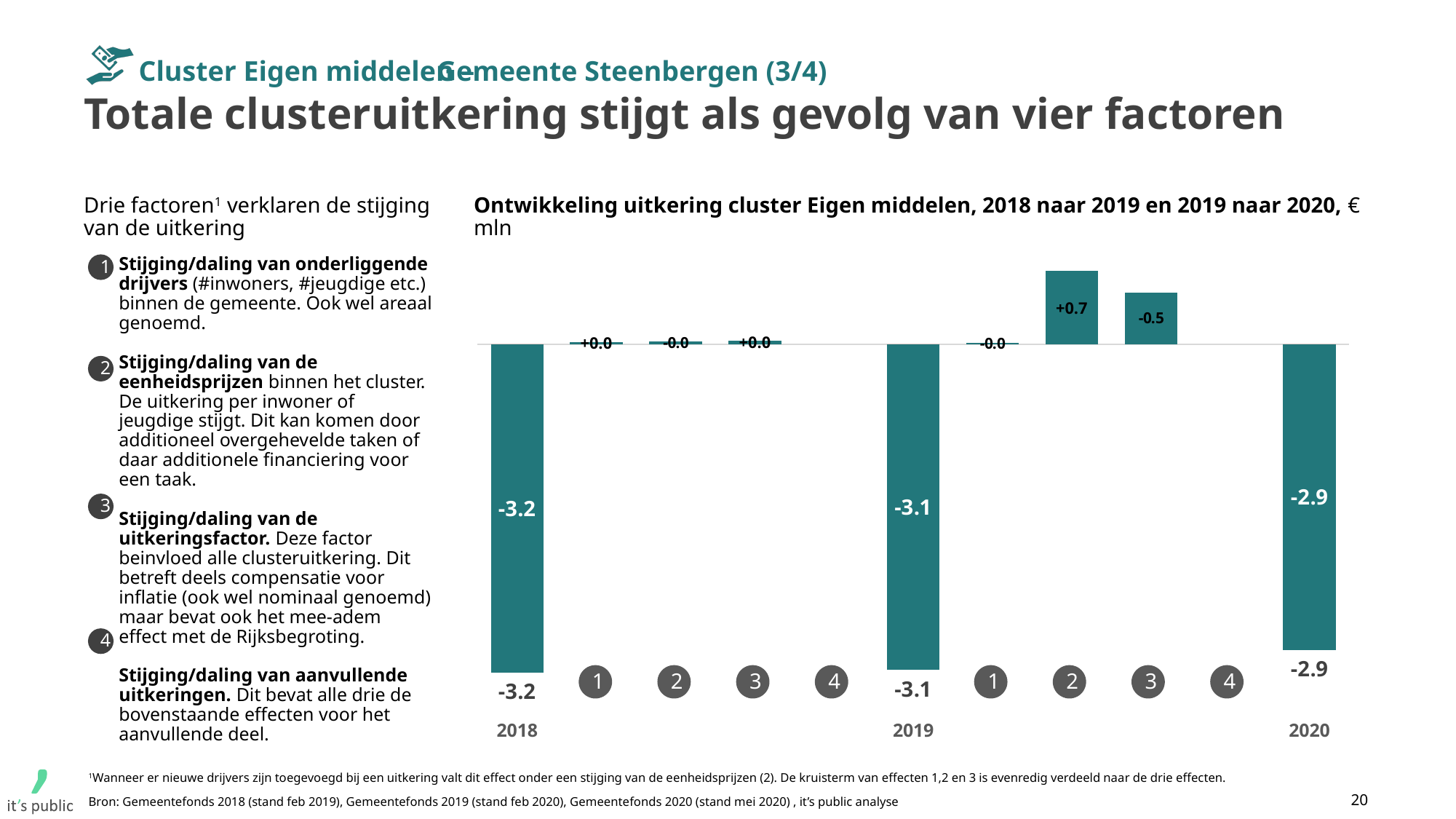
How many year totals (2018, 2019, 2020) are shown in the chart? 3 What is the value of factor 2 in the 2019 to 2020 development? +0.7 Which is larger, the 2019 value or the 2020 value? 2020 What is the value of the 2020 bar in the chart? -2.9 What is the value of factor 3 in the 2019 to 2020 development? -0.5 What is the difference between the 2020 value and the 2018 value? 0.3 What unit is stated in the chart title? € mln What is the value of factor 1 in the 2018 to 2019 development? +0.0 What is the value of the 2019 bar in the chart? -3.1 What kind of chart is shown on the slide? Bar chart (waterfall) Which year has the lowest value: 2018, 2019 or 2020? 2018 What is the value of the 2018 bar in the chart? -3.2